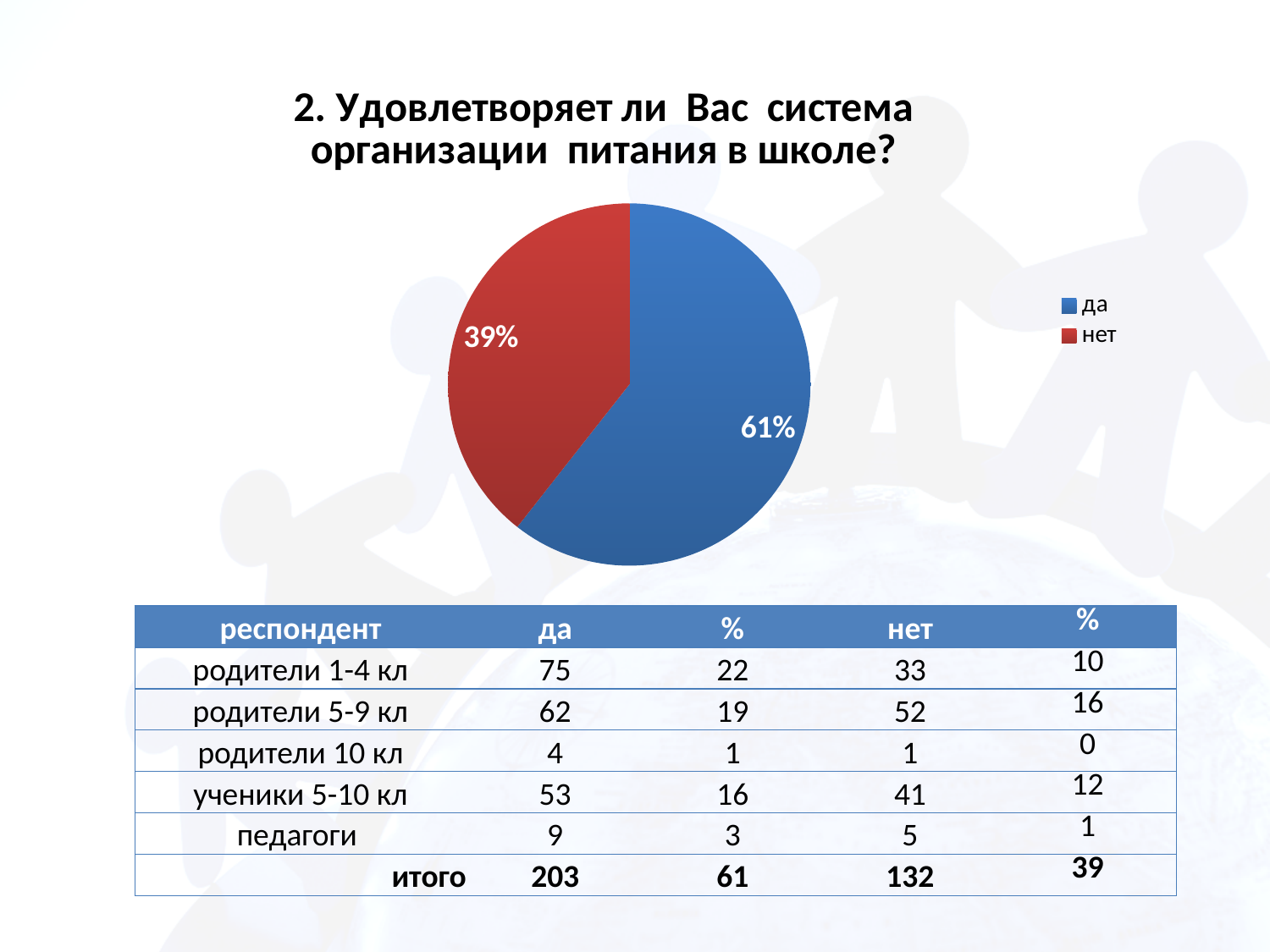
How many entries does the legend of the pie chart list? 2 Which is larger in the pie chart, "да" or "нет"? да What share of the pie does the "да" slice represent? 61% What share of the pie does the "нет" slice represent? 39% Which slice of the pie is the largest? да What colour is the "нет" slice in the pie chart? red How many slices does the pie chart have? 2 Which slice of the pie is the smallest? нет What colour is the "да" slice in the pie chart? blue What is the difference in percentage points between the "да" and "нет" slices? 22 What kind of chart is shown on the slide? pie chart